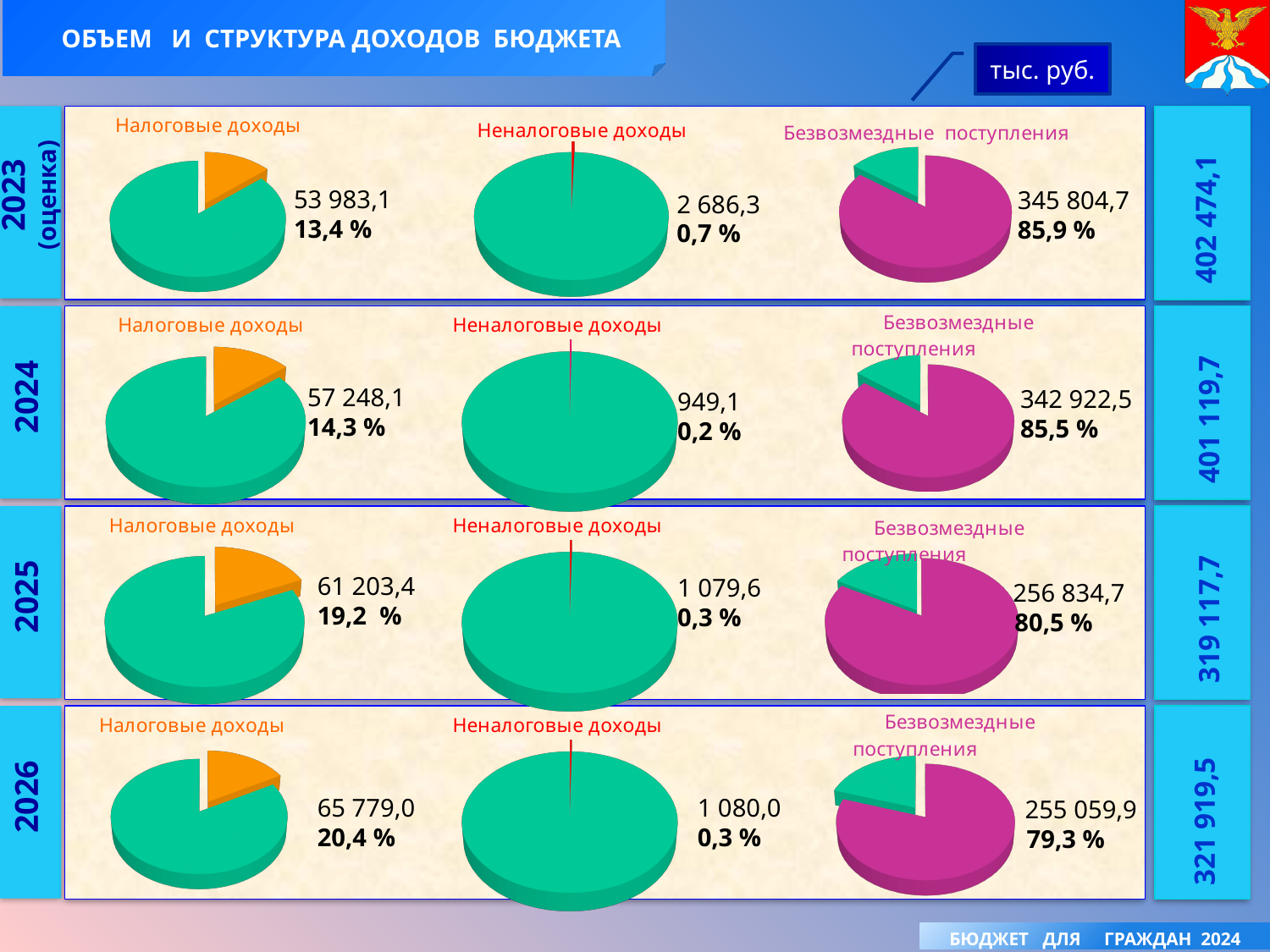
How many pie charts are shown on the slide? 12 On the 2023 (оценка) row, what value is shown on the Налоговые доходы pie chart? 53 983,1 What kind of charts are shown on the slide? Pie charts On the 2025 row, what value is shown on the Безвозмездные поступления pie chart? 256 834,7 On the 2026 row, what value is shown on the Налоговые доходы pie chart? 65 779,0 On the 2026 row, what share does the Безвозмездные поступления pie chart show for that category? 79,3 % On the 2024 row, what value is shown on the Неналоговые доходы pie chart? 949,1 Which is larger: the Налоговые доходы value on the 2025 row or the Налоговые доходы value on the 2024 row? 2025 row (61 203,4) What is the difference between the Неналоговые доходы value on the 2023 (оценка) row and the Неналоговые доходы value on the 2024 row? 1 737,2 Does the share shown for Налоговые доходы rise or fall from the 2023 (оценка) row to the 2026 row? Rise On the 2023 (оценка) row, what share does the Безвозмездные поступления pie chart show for that category? 85,9 % On the 2024 row, what share does the Налоговые доходы pie chart show for that category? 14,3 %